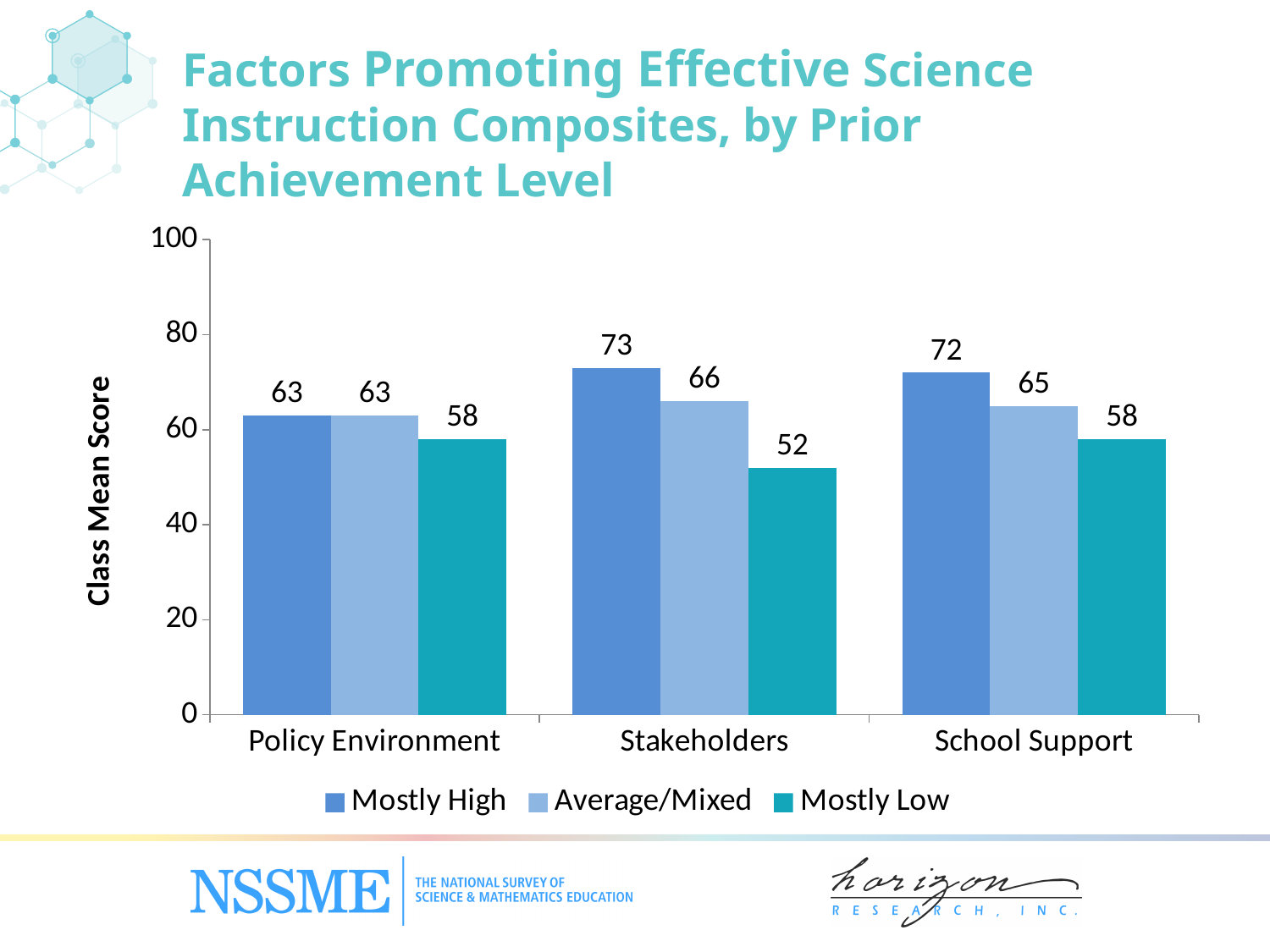
How many composites (categories) are shown on the x axis? 3 Which composite has the highest Class Mean Score for Mostly Low classes? Policy Environment and School Support (both 58) Which composite has the lowest Class Mean Score for Mostly Low classes? Stakeholders What is the label of the y axis? Class Mean Score What is the difference between the Mostly High scores for Stakeholders and Policy Environment? 10 What is the Class Mean Score for Mostly High classes on the Stakeholders composite? 73 How many series does the legend list? 3 Which is larger: the Average/Mixed score for Stakeholders or the Average/Mixed score for Policy Environment? Stakeholders What is the difference between the Mostly High and Mostly Low scores on the Stakeholders composite? 21 What kind of chart is shown on the slide? Bar chart What is the Class Mean Score for Average/Mixed classes on the School Support composite? 65 What is the Class Mean Score for Mostly Low classes on the Policy Environment composite? 58